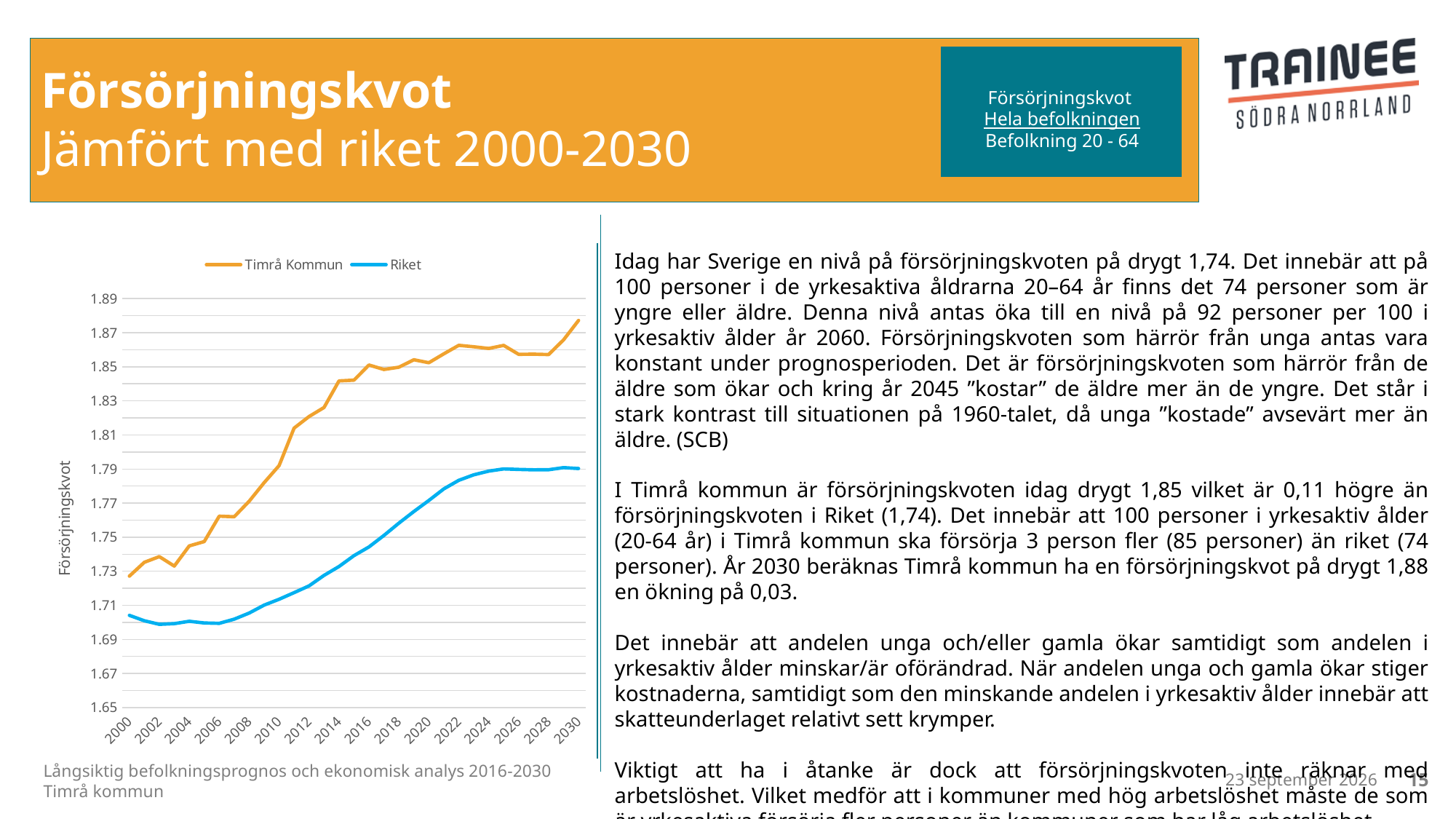
How many series does the chart legend list? 2 Does the Riket line generally rise or fall from 2000 to 2030? rise In which year does the Timrå Kommun line reach its highest value? 2030 Which series has the higher value in 2030, Timrå Kommun or Riket? Timrå Kommun Which two series are shown in the chart legend? Timrå Kommun and Riket What kind of chart is shown on the slide? line chart Is the value for Riket in 2030 greater or less than 1.77? greater How many year labels are shown along the x axis of the chart? 16 Is the value for Timrå Kommun in 2030 greater or less than 1.85? greater What is the label on the vertical axis of the chart? Försörjningskvot Is the value for Riket in 2000 greater or less than 1.71? less